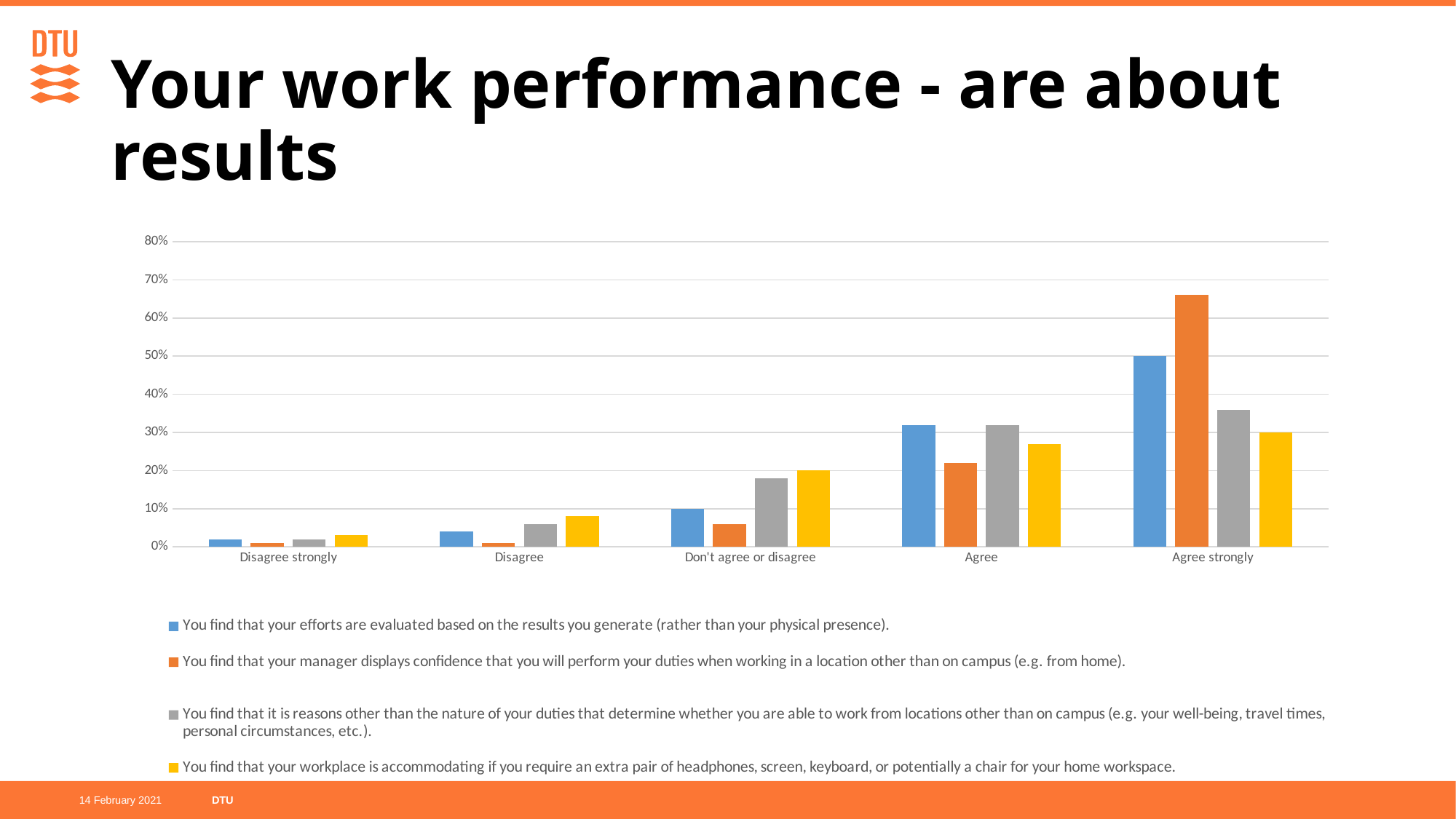
For the 'Agree strongly' category, which series has the larger value: 'You find that your efforts are evaluated based on the results you generate (rather than your physical presence).' or 'You find that your workplace is accommodating if you require an extra pair of headphones, screen, keyboard, or potentially a chair for your home workspace.'? You find that your efforts are evaluated based on the results you generate (rather than your physical presence). How many series does the legend list? 4 Is the value for 'Disagree' in the series 'You find that your workplace is accommodating if you require an extra pair of headphones, screen, keyboard, or potentially a chair for your home workspace.' greater or less than 10%? less Which response category has the tallest bar for the series 'You find that your manager displays confidence that you will perform your duties when working in a location other than on campus (e.g. from home).'? Agree strongly Is the value for 'Agree strongly' in the series 'You find that your manager displays confidence that you will perform your duties when working in a location other than on campus (e.g. from home).' greater or less than 60%? greater Is the value for 'Agree' in the series 'You find that your efforts are evaluated based on the results you generate (rather than your physical presence).' greater or less than 30%? greater How many response categories are shown on the x axis? 5 Which response category has the lowest values across all four series? Disagree strongly Do the values for the series 'You find that your efforts are evaluated based on the results you generate (rather than your physical presence).' rise or fall from 'Disagree strongly' to 'Agree strongly'? rise What colour represents the series 'You find that your workplace is accommodating if you require an extra pair of headphones, screen, keyboard, or potentially a chair for your home workspace.'? yellow What kind of chart is shown on the slide? bar chart